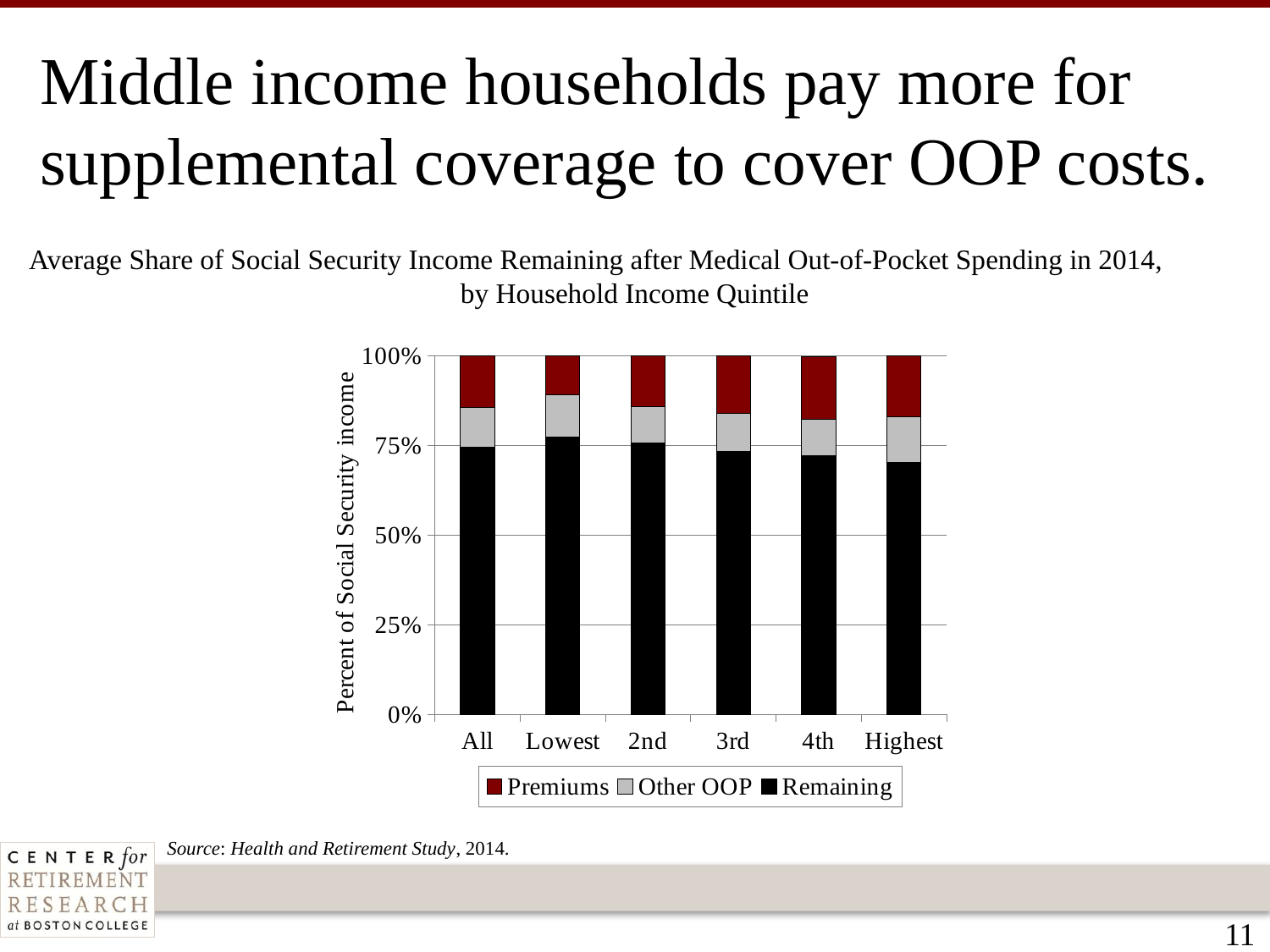
What is the total of the stacked bar for the All category? 100% Moving from the Lowest quintile to the Highest quintile, does the Remaining share rise or fall? fall How many categories are shown along the x axis of the chart? 6 What is the label on the chart's vertical axis? Percent of Social Security income Which category has the largest Remaining share of Social Security income? Lowest What kind of chart is shown on the slide? Stacked bar chart Is the Remaining value for the Lowest quintile greater or less than 75%? greater Which has the larger Premiums segment, the Lowest quintile or the Highest quintile? Highest Is the Remaining value for the Highest quintile greater or less than 75%? less Is the Remaining value for the 4th quintile greater or less than 75%? less How many series does the chart's legend list? 3 Which category has the smallest Remaining share of Social Security income? Highest